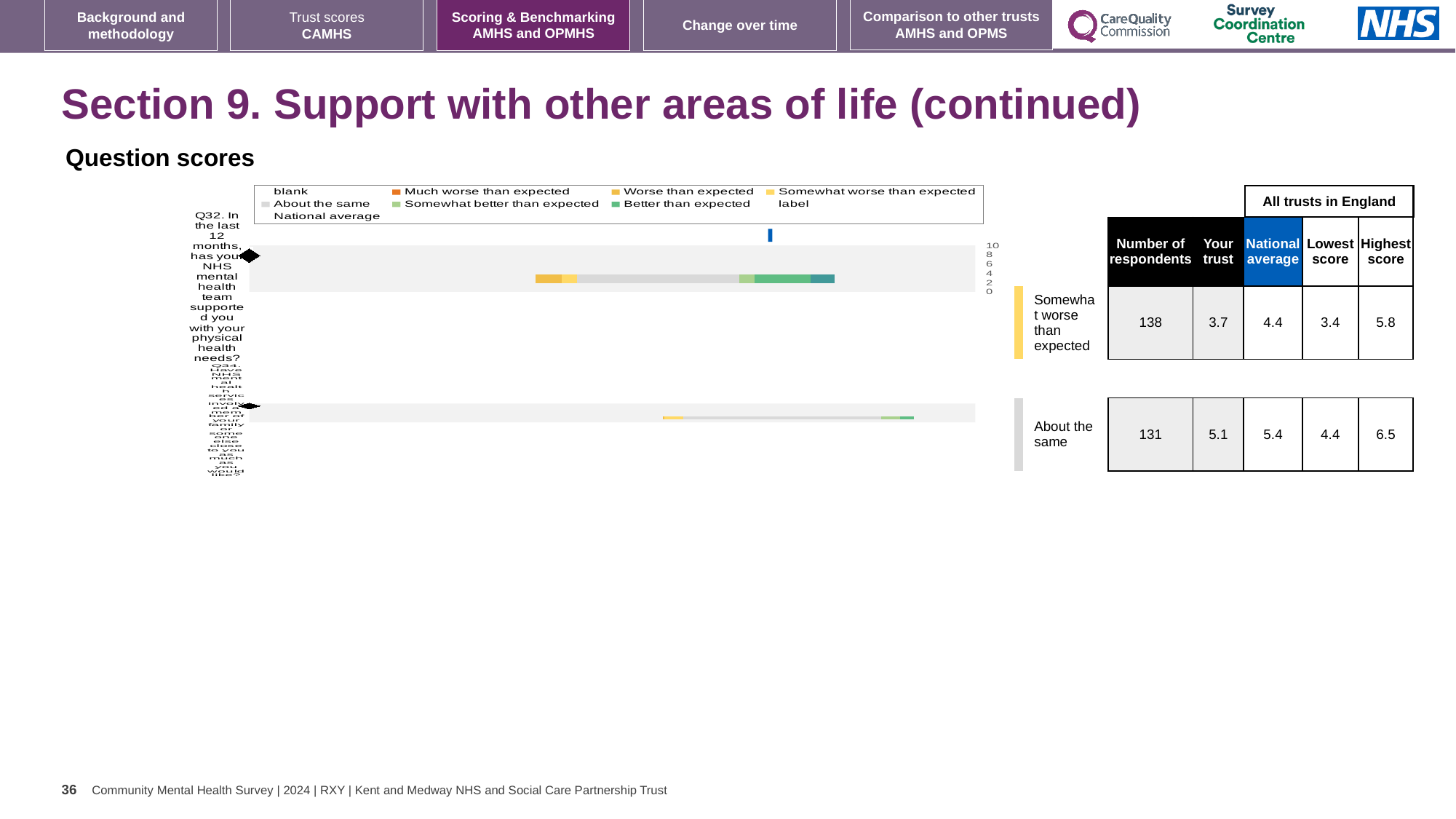
What colour does the legend use for 'Much worse than expected'? orange Which benchmark category is the trust's Q32 score placed in? Somewhat worse than expected How many entries does the chart legend list? 9 How many survey questions are plotted in the chart? 2 Which legend entry is shown in grey? About the same What kind of chart is shown under 'Question scores'? bar chart Which benchmark category is the trust's Q34 score placed in? About the same What is the 'Your trust' score for Q34 (involving family or someone close)? 5.1 Which question has the higher trust score, Q32 or Q34? Q34 What is the difference between the trust scores for Q34 and Q32? 1.4 What is the national average score for Q32? 4.4 What is the 'Your trust' score for Q32 (support with physical health needs)? 3.7